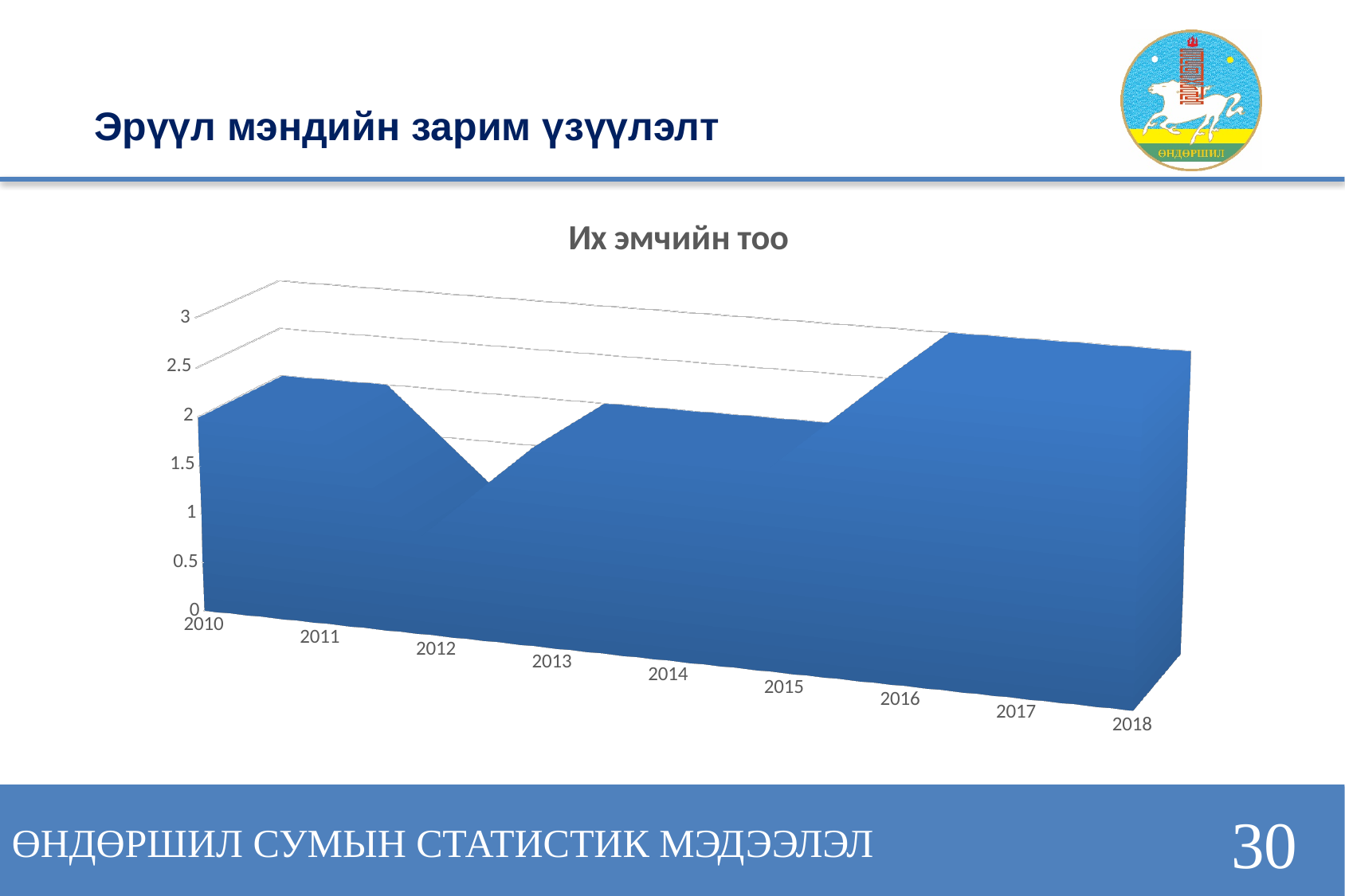
Is the value for 2017 greater or less than 2.5? greater Which is larger, the value for 2014 or the value for 2016? 2016 Which year has the lowest value in the chart? 2012 What is the first year shown on the x axis? 2010 What kind of chart is shown on the slide? area chart Does the value rise or fall from 2015 to 2016? rise Is the value for 2018 greater or less than 1? greater How many years are shown along the x axis of the chart? 9 Is the value for 2010 greater or less than 1.5? greater Which is larger, the value for 2012 or the value for 2017? 2017 What is the title of the chart? Их эмчийн тоо